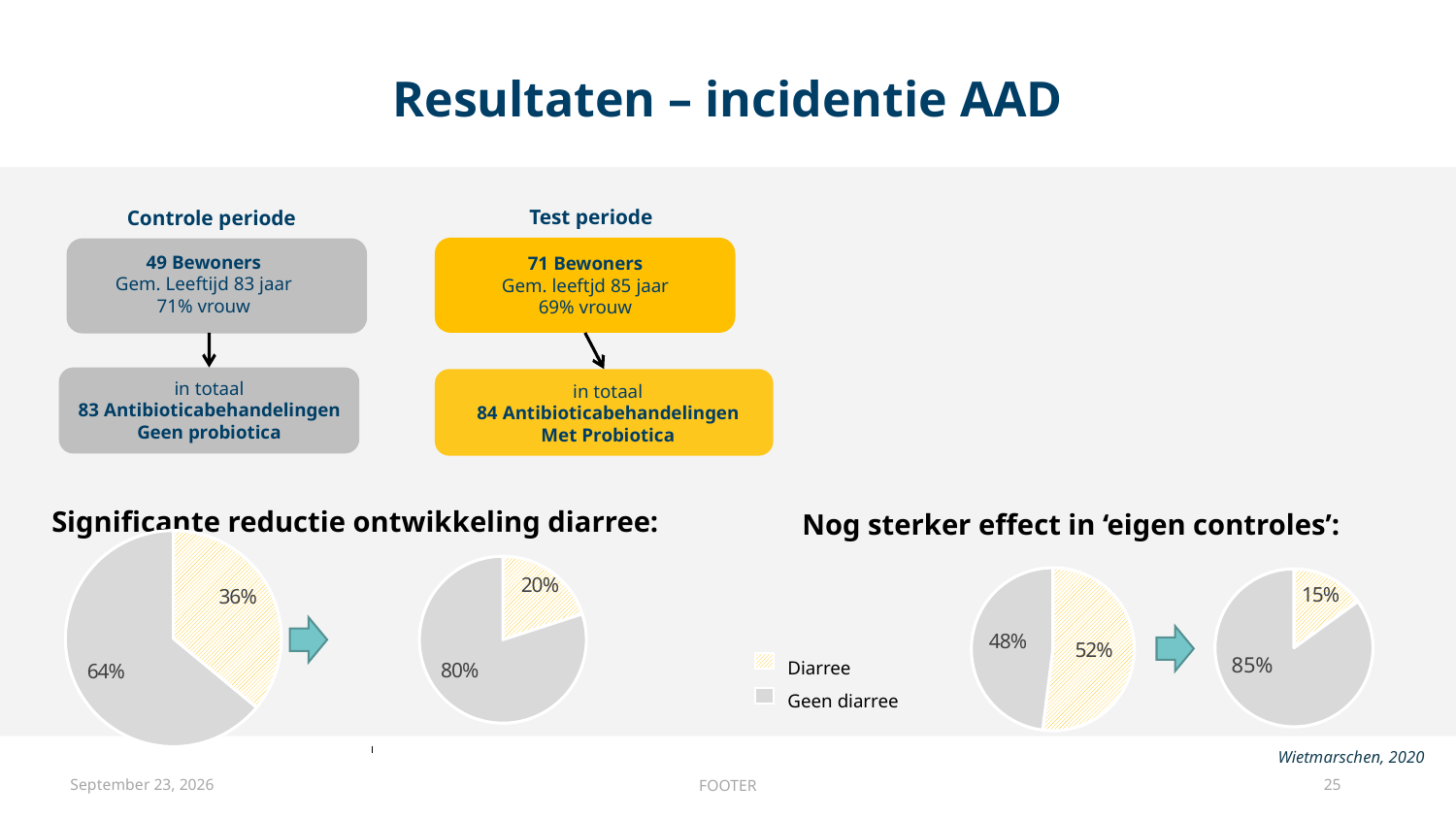
In the second pie chart from the left (right of the arrow under 'Significante reductie ontwikkeling diarree'), what share is labelled for the Diarree slice? 20% In the leftmost pie chart under 'Significante reductie ontwikkeling diarree', what share is labelled for the Geen diarree slice? 64% How many pie charts are shown on the slide? 4 In the leftmost pie chart under 'Significante reductie ontwikkeling diarree', what share is labelled for the Diarree slice? 36% What kind of charts are shown at the bottom of the slide? Pie charts How many entries does the legend between the pie charts list? 2 In the rightmost pie chart on the slide, what share is labelled for the Geen diarree slice? 85% What is the difference between the Diarree share in the leftmost pie chart (36%) and the Diarree share in the second pie chart from the left (20%)? 16% In the left pie chart under 'Nog sterker effect in eigen controles', what share is labelled for the Diarree slice? 52% In the left pie chart under 'Nog sterker effect in eigen controles', what share is labelled for the Geen diarree slice? 48% In the rightmost pie chart on the slide, what share is labelled for the Diarree slice? 15% In the second pie chart from the left (right of the arrow under 'Significante reductie ontwikkeling diarree'), what share is labelled for the Geen diarree slice? 80%